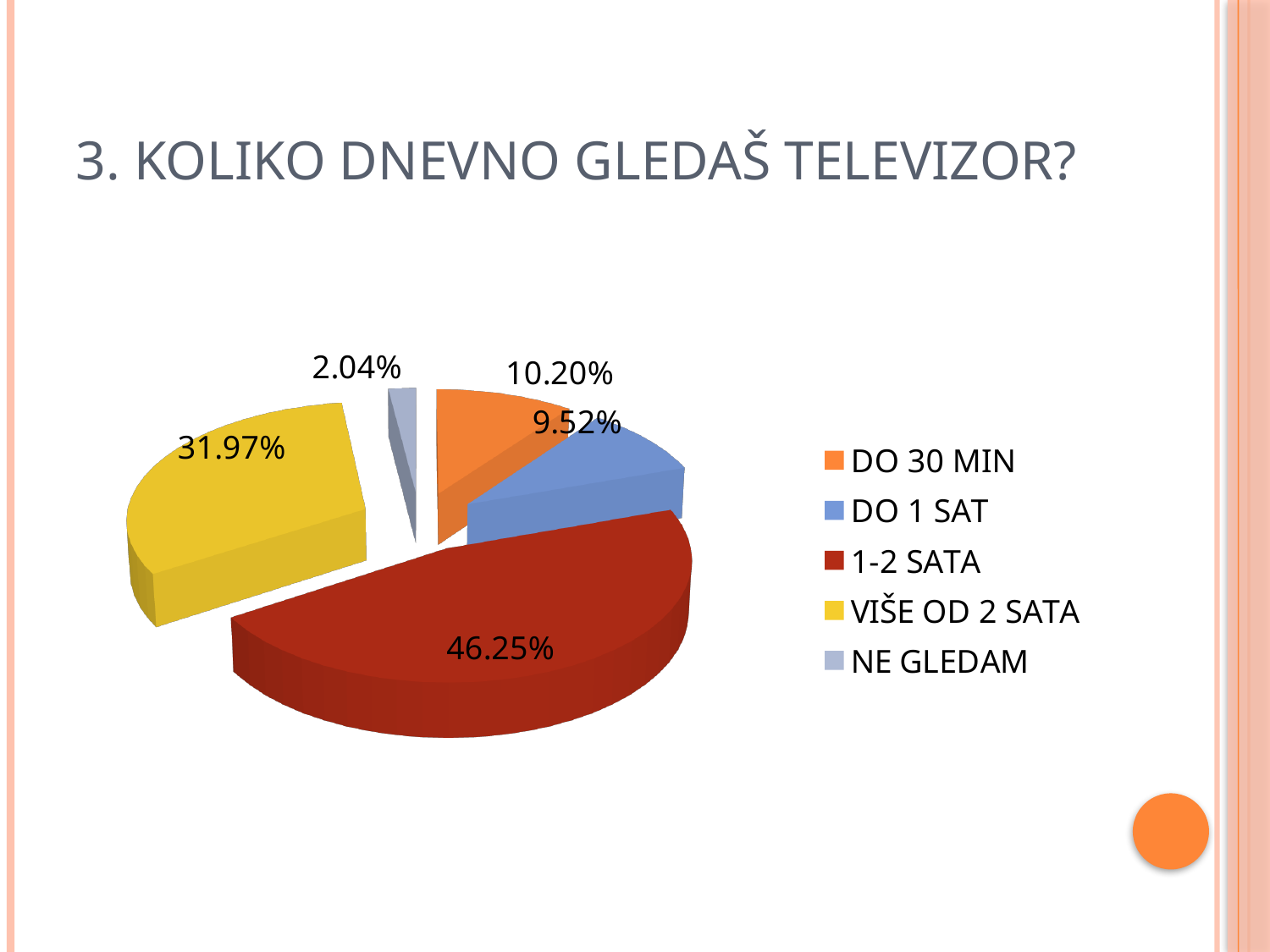
How many categories does the pie chart show? 5 What percentage of respondents answered VIŠE OD 2 SATA? 31.97% What colour is the slice for VIŠE OD 2 SATA? Yellow Which category has the smallest share of the pie? NE GLEDAM What percentage of respondents answered 1-2 SATA? 46.25% What is the difference in percentage points between 1-2 SATA and VIŠE OD 2 SATA? 14.28 What percentage of respondents answered NE GLEDAM? 2.04% What percentage of respondents answered DO 30 MIN? 10.20% Which category has the largest share of the pie? 1-2 SATA What kind of chart is shown on the slide? Pie chart Which is larger, the share for DO 30 MIN or the share for DO 1 SAT? DO 30 MIN What is the title of the slide? 3. KOLIKO DNEVNO GLEDAŠ TELEVIZOR?